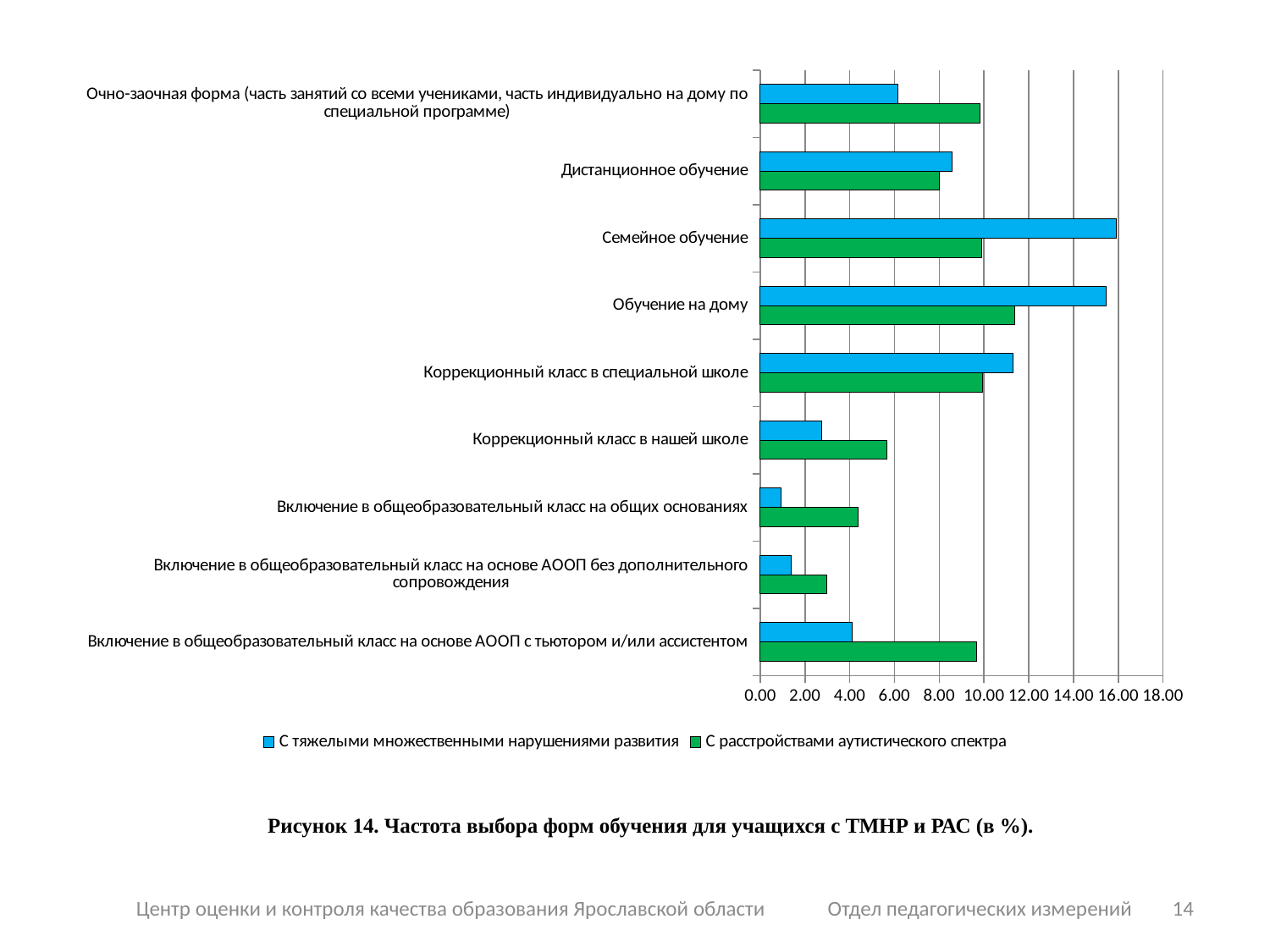
How many series does the legend list? 2 What is the caption (figure title) given below the chart? Рисунок 14. Частота выбора форм обучения для учащихся с ТМНР и РАС (в %). Which category has the highest value for the series 'С расстройствами аутистического спектра'? Обучение на дому What kind of chart is shown on the slide? bar chart Is the value for 'Коррекционный класс в нашей школе' in the series 'С расстройствами аутистического спектра' greater or less than 8.00? less Which category has the highest value for the series 'С тяжелыми множественными нарушениями развития'? Семейное обучение Which category has the lowest value for the series 'С тяжелыми множественными нарушениями развития'? Включение в общеобразовательный класс на общих основаниях Which category has the lowest value for the series 'С расстройствами аутистического спектра'? Включение в общеобразовательный класс на основе АООП без дополнительного сопровождения For 'Включение в общеобразовательный класс на основе АООП с тьютором и/или ассистентом', which series has the larger value? С расстройствами аутистического спектра How many categories (forms of education) are plotted on the chart? 9 For 'Семейное обучение', which series has the larger value: 'С тяжелыми множественными нарушениями развития' or 'С расстройствами аутистического спектра'? С тяжелыми множественными нарушениями развития Is the value for 'Обучение на дому' in the series 'С тяжелыми множественными нарушениями развития' greater or less than 14.00? greater